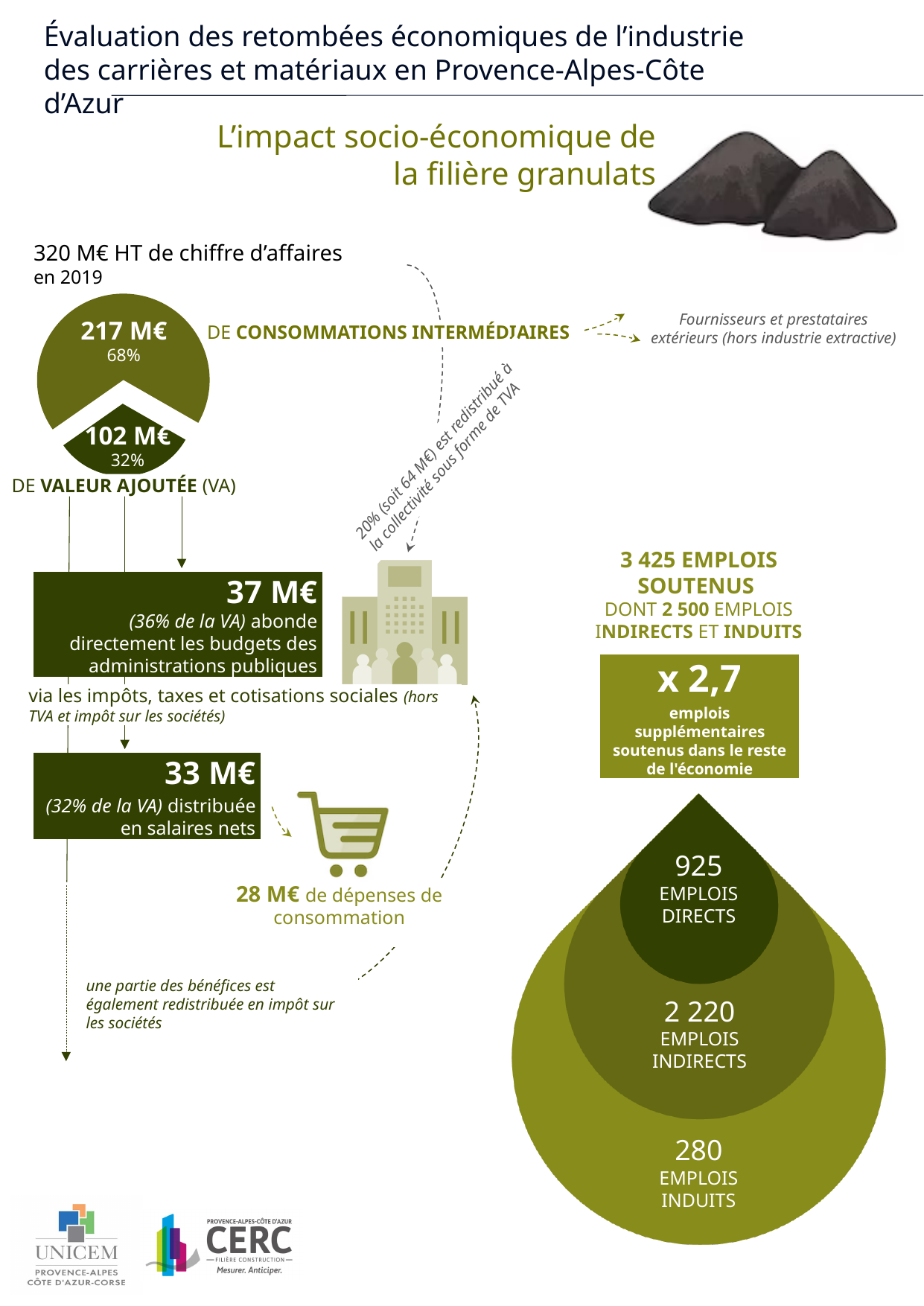
In the nested circles diagram on the right, how many emplois indirects are shown? 2 220 In the nested circles diagram on the right, which category of jobs has the lowest value? emplois induits In the pie chart on the left, what value is shown for consommations intermédiaires? 217 M€ What type of chart is used on the left to split the 320 M€ of chiffre d'affaires? pie chart In the pie chart on the left, what value is shown for valeur ajoutée (VA)? 102 M€ In the pie chart on the left, which slice is larger: consommations intermédiaires or valeur ajoutée? consommations intermédiaires How many slices does the pie chart on the left have? 2 In the pie chart on the left, what is the difference between consommations intermédiaires and valeur ajoutée? 115 M€ In the pie chart on the left, what share of the total does valeur ajoutée represent? 32% In the pie chart on the left, what share of the total do consommations intermédiaires represent? 68% In the nested circles diagram on the right, how many emplois directs are shown? 925 In the nested circles diagram on the right, what is the difference between emplois indirects and emplois directs? 1 295